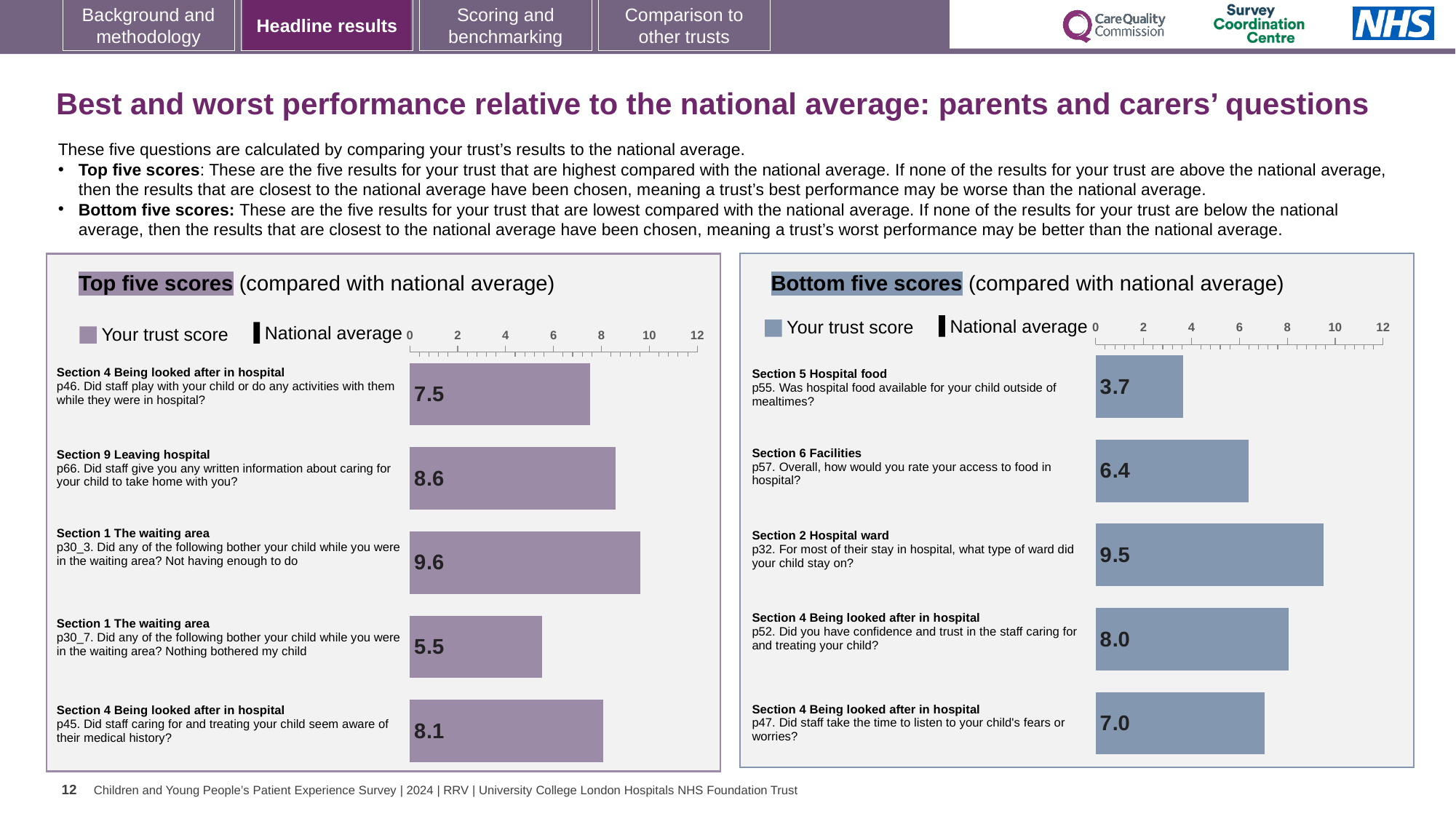
In the Bottom five scores chart, is the trust score for p57 greater or less than 8? less In the Top five scores chart, which question has the lowest trust score? p30_7 (Nothing bothered my child), 5.5 How many bars are shown in the Top five scores chart? 5 How many entries does the legend of the Top five scores chart list? 2 What type of chart is the Bottom five scores chart? Bar chart In the Bottom five scores chart, what is the trust score for p55 (Was hospital food available for your child outside of mealtimes?)? 3.7 In the Bottom five scores chart, which question has the lowest trust score? p55 (Hospital food), 3.7 In the Bottom five scores chart, what is the difference between the scores for p52 and p47? 1.0 In the Top five scores chart, what is the trust score for p66 (Did staff give you any written information about caring for your child to take home with you?)? 8.6 In the Top five scores chart, which question has the highest trust score? p30_3 (Not having enough to do), 9.6 In the Bottom five scores chart, which has the larger trust score: p32 or p52? p32 (9.5) In the Top five scores chart, what is the difference between the scores for p30_3 and p30_7? 4.1